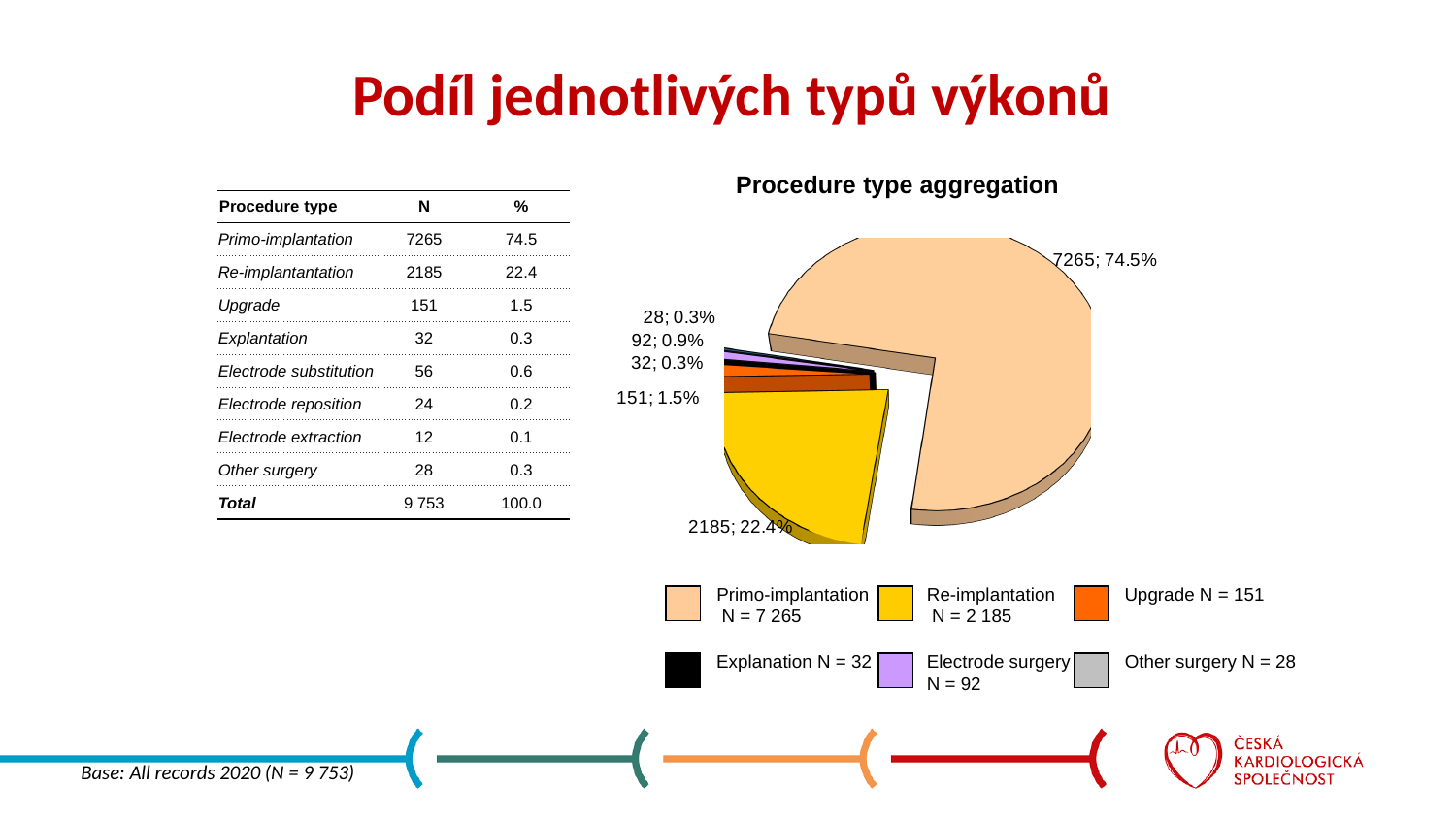
What colour is the Re-implantation slice in the "Procedure type aggregation" pie chart? yellow In the "Procedure type aggregation" chart, which slice is larger: Electrode surgery or Upgrade? Upgrade Which slice is the largest in the "Procedure type aggregation" pie chart? Primo-implantation How many entries does the legend of the "Procedure type aggregation" chart list? 6 In the "Procedure type aggregation" chart, what is the difference in N between Primo-implantation (7265) and Re-implantation (2185)? 5080 What percentage share does the Re-implantation slice have in the "Procedure type aggregation" pie chart? 22.4% How many slices does the "Procedure type aggregation" pie chart have? 6 Which slice is the smallest in the "Procedure type aggregation" pie chart? Other surgery What is the N value shown on the data label for the Upgrade slice in the "Procedure type aggregation" chart? 151 What percentage share does the Primo-implantation slice have in the "Procedure type aggregation" pie chart? 74.5% What percentage share does the Electrode surgery slice have in the "Procedure type aggregation" pie chart? 0.9% What type of chart is shown under the title "Procedure type aggregation"? pie chart